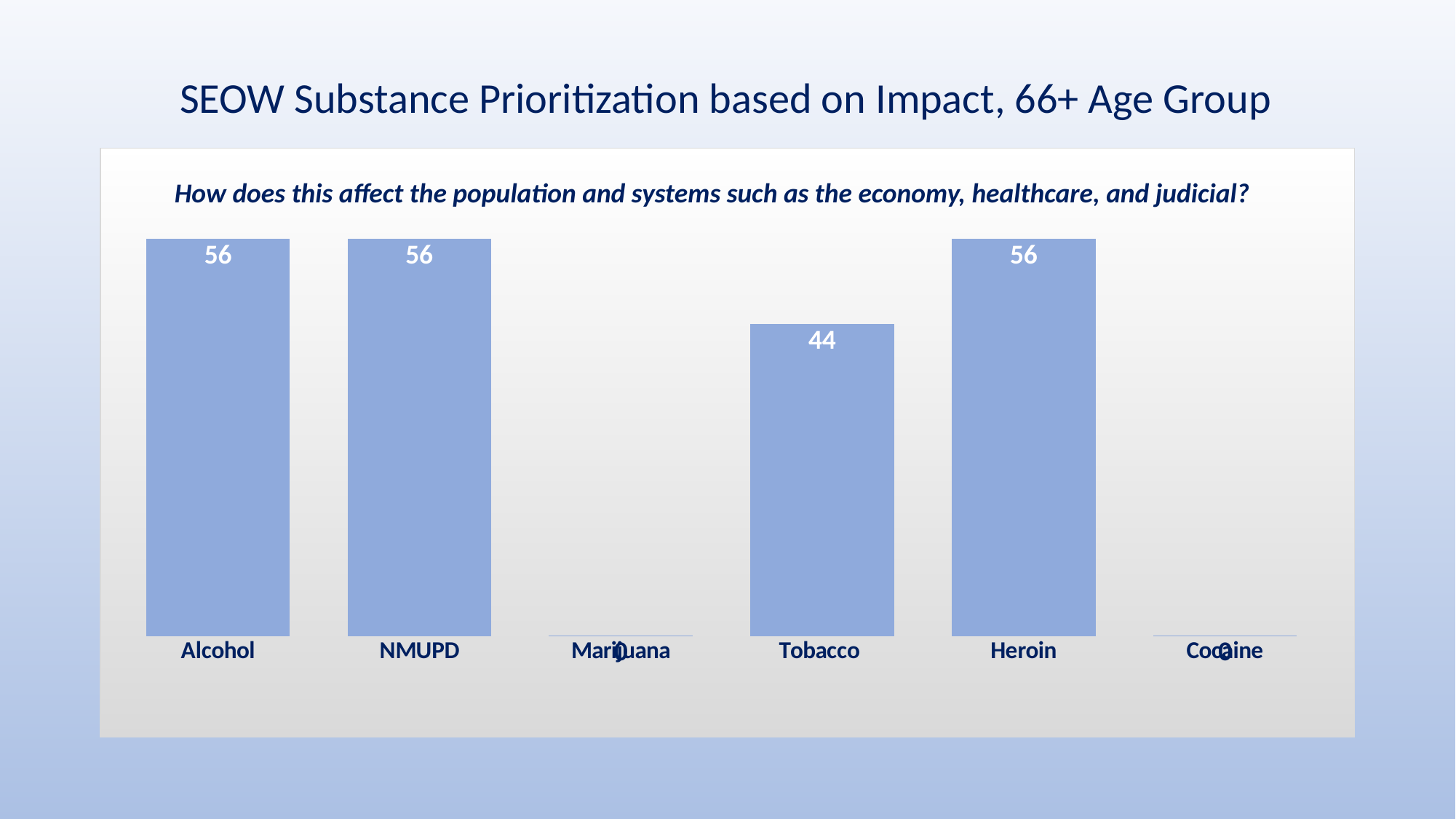
What is the value for Tobacco? 44 What is the value for Alcohol? 56 What is the difference between the value for Heroin and the value for Tobacco? 12 What is the value for Heroin? 56 Which is larger, the value for Tobacco or the value for Cocaine? Tobacco What kind of chart is shown on the slide? Bar chart What is the title of the chart? How does this affect the population and systems such as the economy, healthcare, and judicial? Which is larger, the value for Alcohol or the value for Tobacco? Alcohol What is the value for Marijuana? 0 How many categories are shown on the x axis? 6 What is the value for NMUPD? 56 What is the value for Cocaine? 0